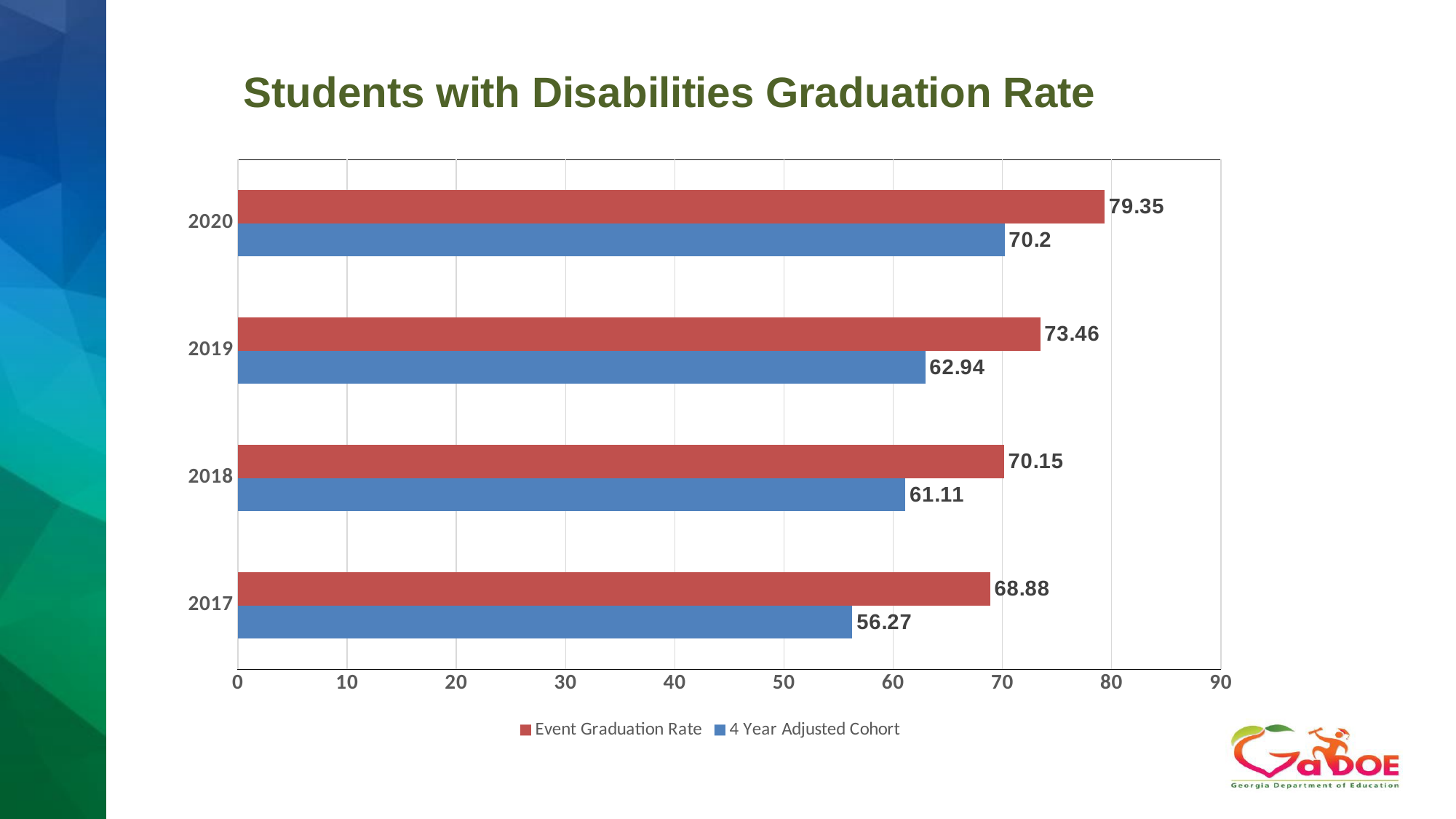
What kind of chart is shown on the slide? Bar chart What is the 4 Year Adjusted Cohort value for 2017? 56.27 What is the 4 Year Adjusted Cohort value for 2019? 62.94 Is the 4 Year Adjusted Cohort value for 2020 greater or less than 60? greater Which year has the highest Event Graduation Rate? 2020 What is the difference between the Event Graduation Rate and the 4 Year Adjusted Cohort value in 2018? 9.04 What is the Event Graduation Rate for 2020? 79.35 How many years are shown on the chart? 4 Which is larger in 2019: the Event Graduation Rate or the 4 Year Adjusted Cohort value? Event Graduation Rate How many series does the legend list? 2 Does the Event Graduation Rate rise or fall from 2017 to 2020? Rise Which year has the lowest 4 Year Adjusted Cohort value? 2017